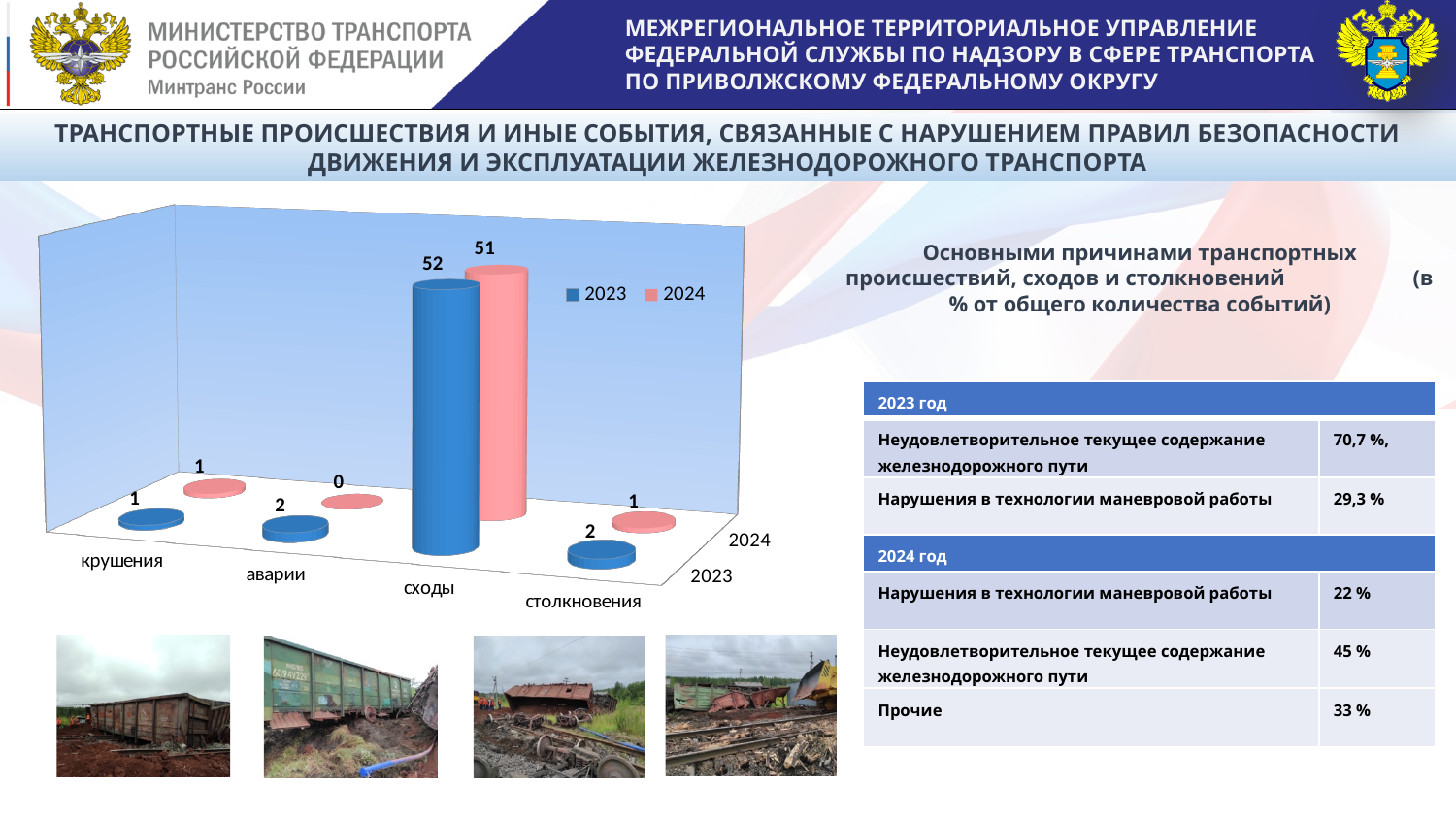
What is the value for аварии in 2024? 0 What is the value for сходы in 2023? 52 How many series does the legend list? 2 What is the value for крушения in 2024? 1 Which is larger: the 2023 value for аварии or the 2024 value for аварии? 2023 Which category has the highest value in 2023? сходы What kind of chart is shown on the slide? bar chart What is the value for сходы in 2024? 51 How many categories are shown on the chart? 4 Which category has the lowest value in 2024? аварии What is the difference between the 2023 and 2024 values for сходы? 1 What is the value for столкновения in 2023? 2